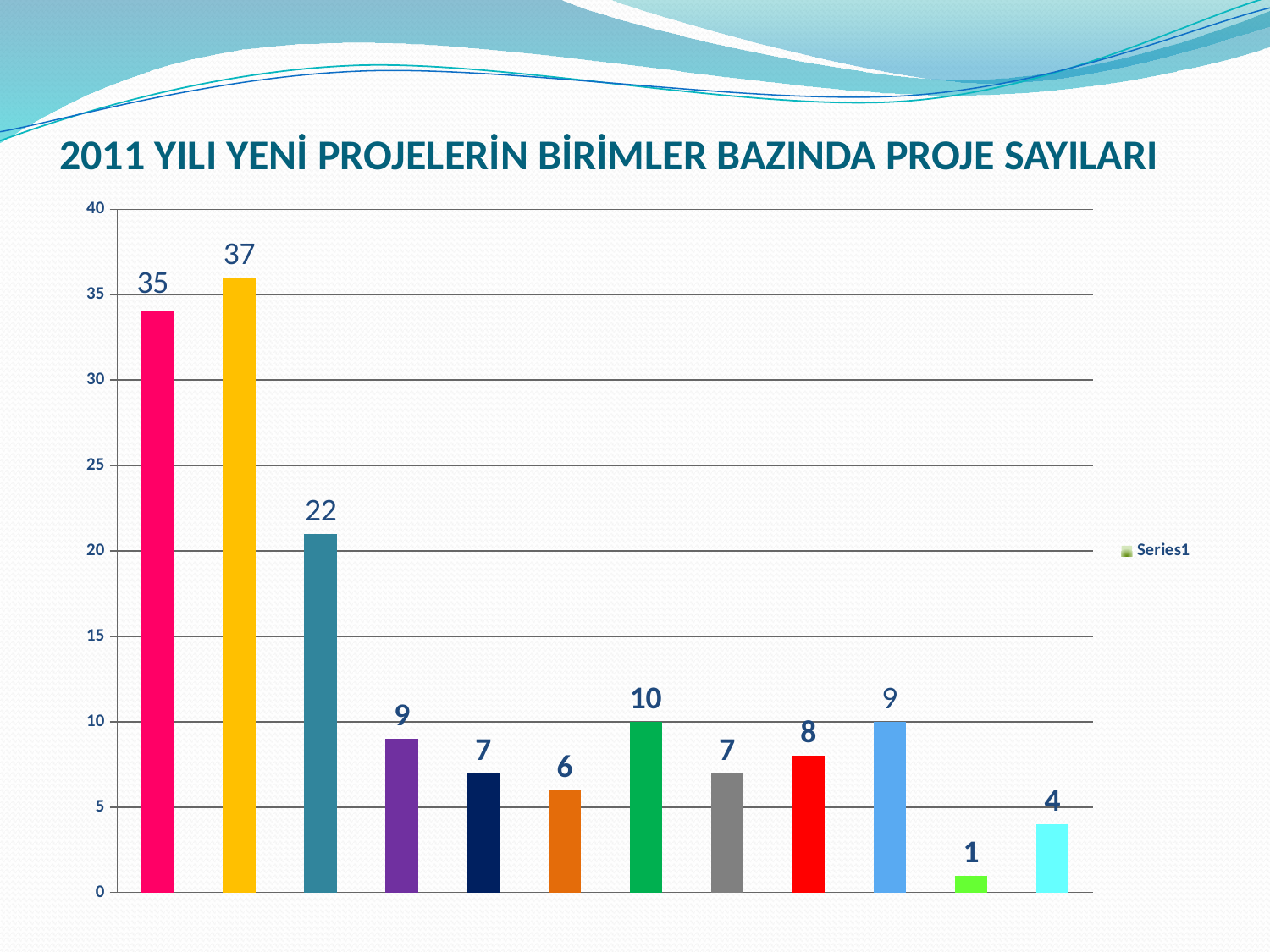
What is the title of the chart? 2011 YILI YENİ PROJELERİN BİRİMLER BAZINDA PROJE SAYILARI What is the difference between the yellow bar (37) and the pink bar (35)? 2 What is the value shown on the teal (third) bar? 22 What type of chart is shown on the slide? bar chart Which bar has the lowest value? the light green (eleventh) bar, 1 What is the value shown on the pink (first) bar? 35 How many series does the legend list? 1 What is the value shown on the light green (eleventh) bar? 1 How many bars are plotted in the chart? 12 What is the value shown on the yellow (second) bar? 37 Which is larger, the value of the green (seventh) bar or the red (ninth) bar? the green (seventh) bar, 10 Which bar has the highest value? the yellow (second) bar, 37